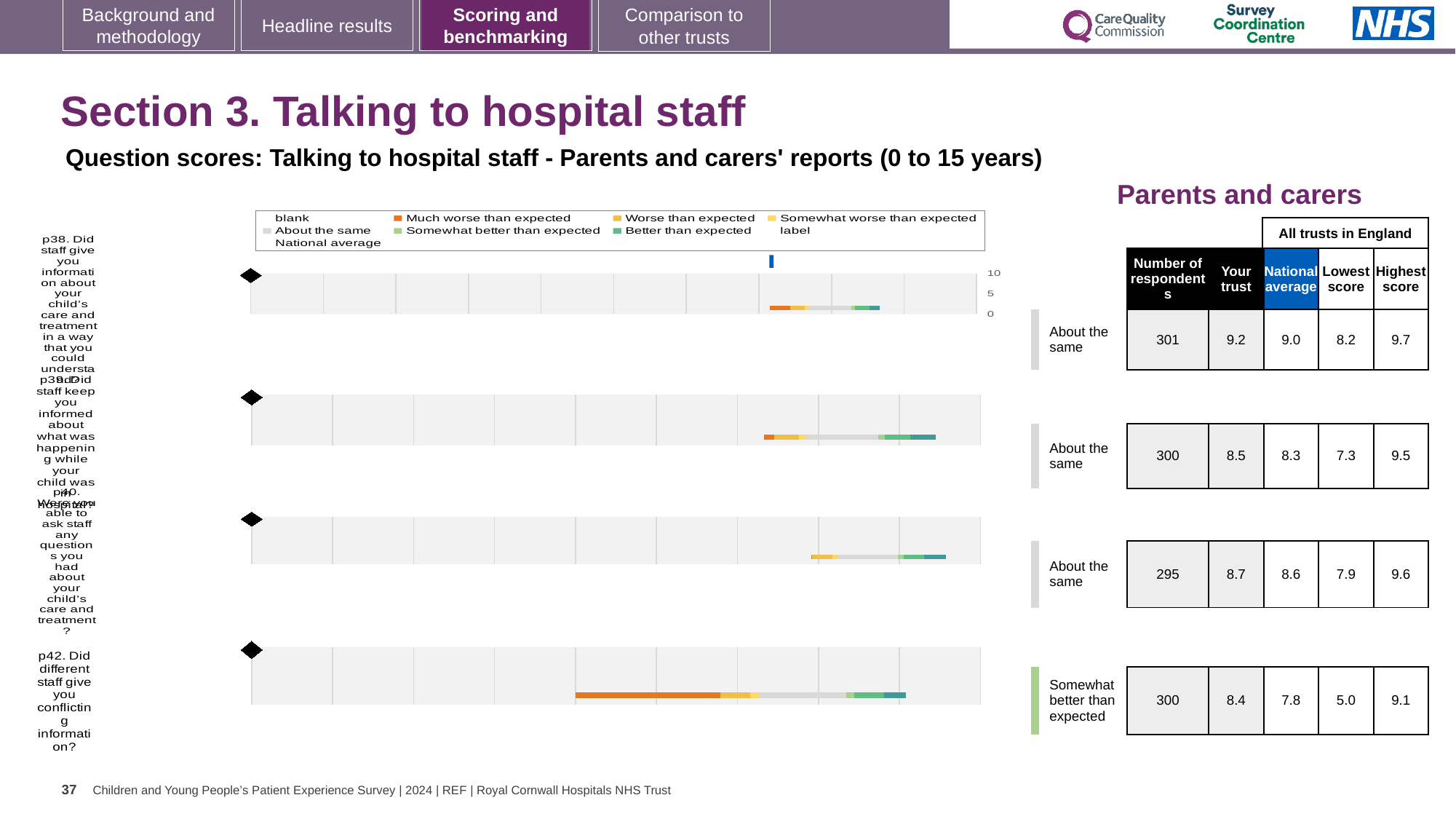
What type of chart is used to show the question scores on this slide? bar chart Which colour in the legend represents 'Much worse than expected'? orange What is the number of respondents for question p38 (Did staff give you information about your child's care and treatment in a way that you could understand)? 301 Which question has the lowest 'Lowest score' across all trusts in England? p42 What is the highest score across all trusts in England for question p40 (Were you able to ask staff any questions you had about your child's care and treatment)? 9.6 How many survey questions (bars) are plotted on the slide? 4 What is the 'Your trust' score for question p39 (Did staff keep you informed about what was happening while your child was in hospital)? 8.5 How many of the four questions are rated 'About the same' as expected? 3 Which question has the highest 'Your trust' score? p38 What is the difference between the 'Your trust' score and the national average for question p42? 0.6 For question p39, which is larger: the 'Your trust' score or the national average? Your trust What is the national average score for question p42 (Did different staff give you conflicting information)? 7.8